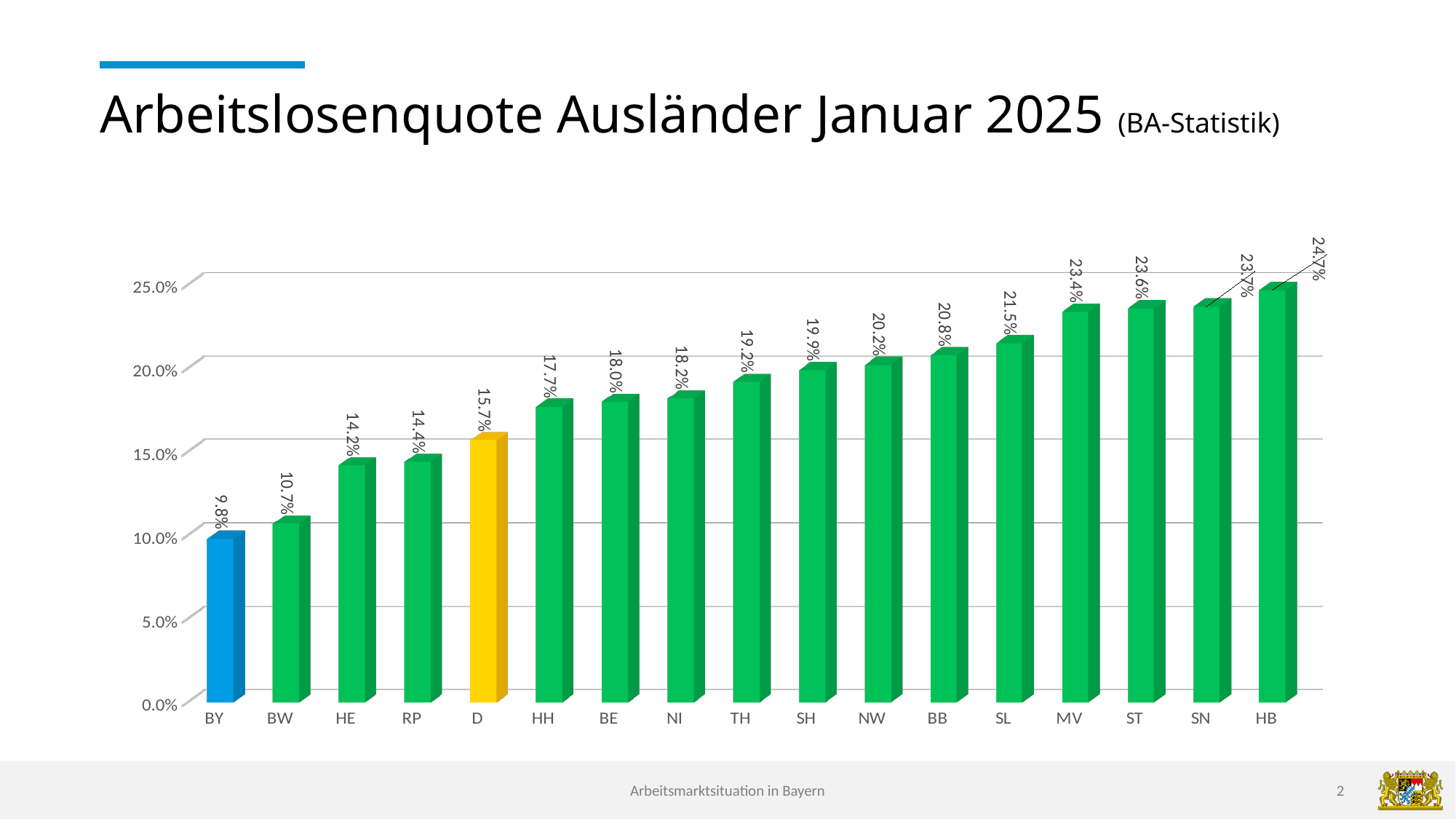
Which category has the lowest value? BY How many categories are shown on the x axis? 17 Which category has the highest value? HB Do the values rise or fall from left to right along the x axis? rise What is the value for D? 15.7% What is the difference between the values for HB and BY? 14.9% What kind of chart is this? bar chart What is the value for NW? 20.2% Which bar is coloured yellow? D What is the value for BY? 9.8% Is the value for TH greater or less than 20.0%? less Which is larger, the value for HE or the value for SL? SL